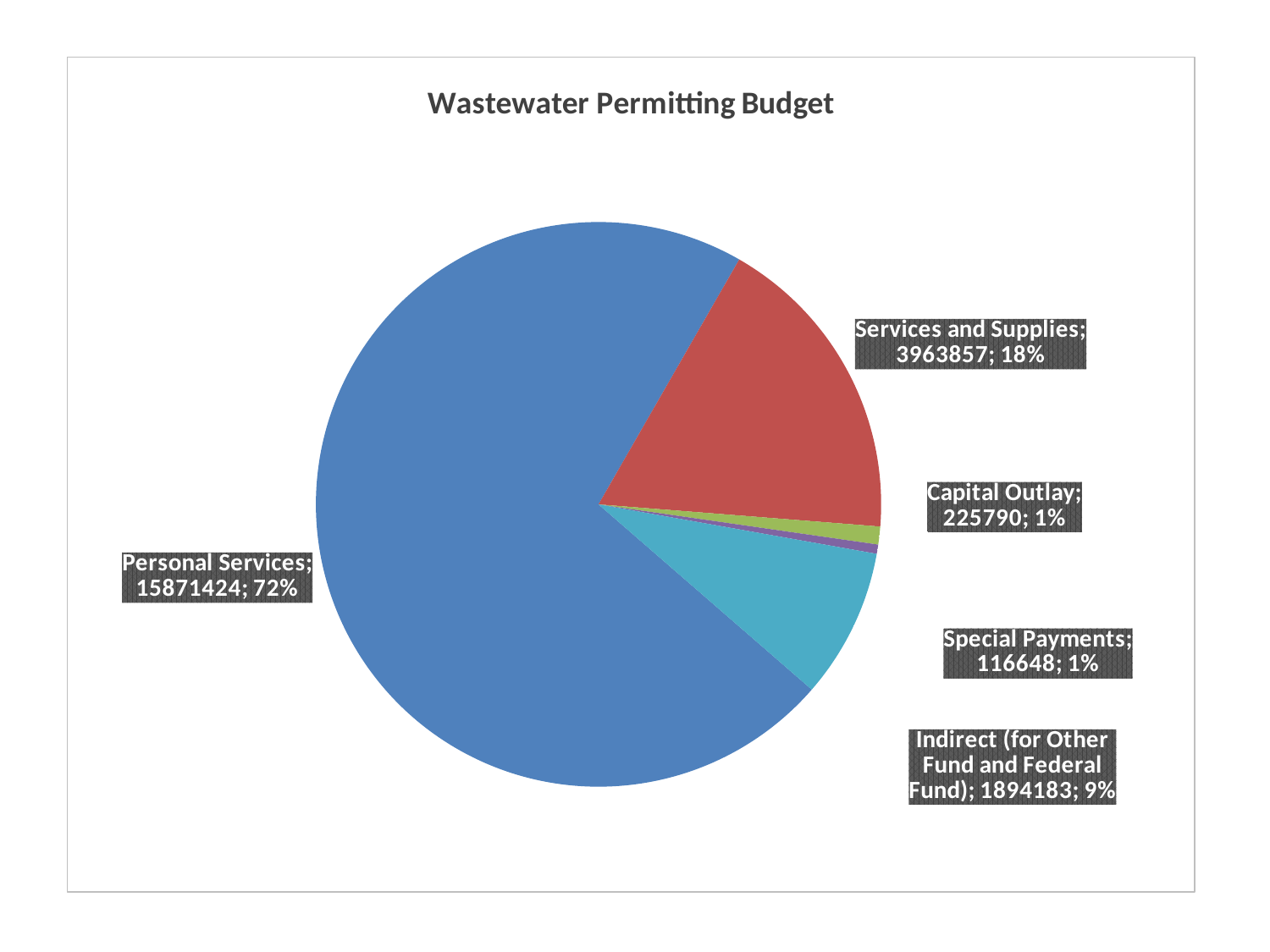
What percentage share does Services and Supplies have? 18% What kind of chart is shown? Pie chart Which category has the smallest slice? Special Payments What is the title of the chart? Wastewater Permitting Budget What is the value for Indirect (for Other Fund and Federal Fund)? 1894183 What is the value for Personal Services? 15871424 How many categories are shown in the pie chart? 5 Which is larger, Services and Supplies or Indirect (for Other Fund and Federal Fund)? Services and Supplies What is the difference between Personal Services and Services and Supplies? 11907567 Which category has the largest slice? Personal Services What is the value for Capital Outlay? 225790 What is the difference between Capital Outlay and Special Payments? 109142